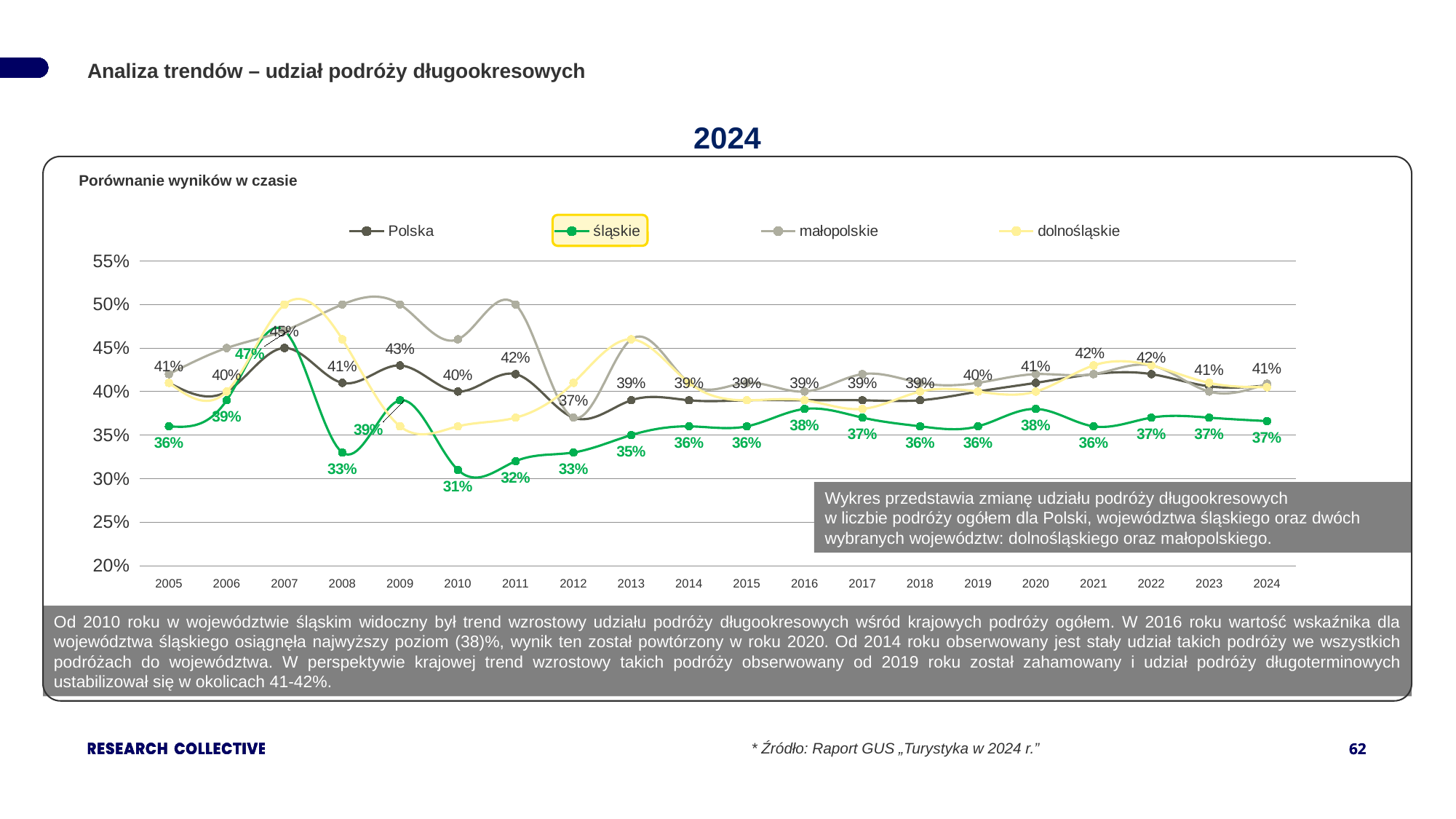
How many series does the chart legend list? 4 In which year does the śląskie series reach its highest value? 2007 What is the value for śląskie in 2016? 38% What is the value for Polska in 2007? 45% What type of chart is shown on the slide? line chart Which is larger in 2007: the value for Polska or the value for śląskie? śląskie Is the value for małopolskie in 2008 greater or less than 45%? greater Which series in the legend is highlighted with a yellow box? śląskie How many years are shown on the x axis of the chart? 20 In which year does the śląskie series reach its lowest value? 2010 What is the difference between the Polska value and the śląskie value in 2024? 4 percentage points What is the value for śląskie in 2010? 31%